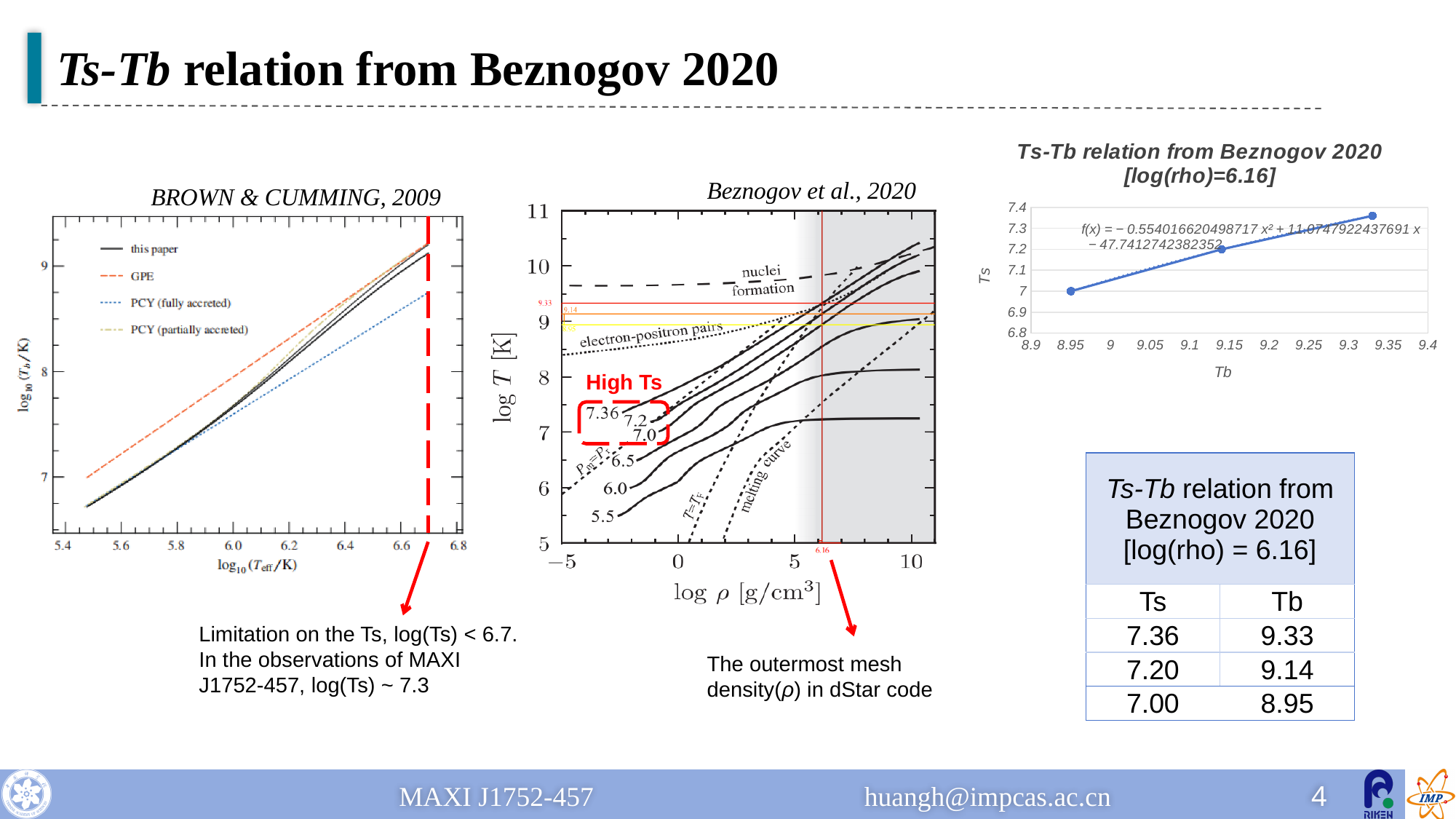
On the chart titled 'Ts-Tb relation from Beznogov 2020 [log(rho)=6.16]', what is the label of the horizontal axis? Tb On the BROWN & CUMMING, 2009 chart, how many series does the legend list? 4 According to the table 'Ts-Tb relation from Beznogov 2020 [log(rho) = 6.16]', what is Tb when Ts is 7.36? 9.33 On the chart titled 'Ts-Tb relation from Beznogov 2020 [log(rho)=6.16]', is the Ts value of the rightmost point (Tb = 9.33) greater or less than 7.2? greater On the Beznogov et al., 2020 chart, at what value of log rho is the vertical red line drawn? 6.16 On the chart titled 'Ts-Tb relation from Beznogov 2020 [log(rho)=6.16]', how many data points are plotted? 3 According to the table 'Ts-Tb relation from Beznogov 2020 [log(rho) = 6.16]', what is Ts when Tb is 9.14? 7.20 On the chart titled 'Ts-Tb relation from Beznogov 2020 [log(rho)=6.16]', is the Ts value of the leftmost point (Tb = 8.95) greater or less than 7.1? less On the chart titled 'Ts-Tb relation from Beznogov 2020 [log(rho)=6.16]', which Tb value has the highest Ts? 9.33 According to the table 'Ts-Tb relation from Beznogov 2020 [log(rho) = 6.16]', what is the difference between the highest and lowest Ts values? 0.36 On the chart titled 'Ts-Tb relation from Beznogov 2020 [log(rho)=6.16]', does Ts rise or fall as Tb increases? rise On the chart titled 'Ts-Tb relation from Beznogov 2020 [log(rho)=6.16]', what kind of chart is it? line chart